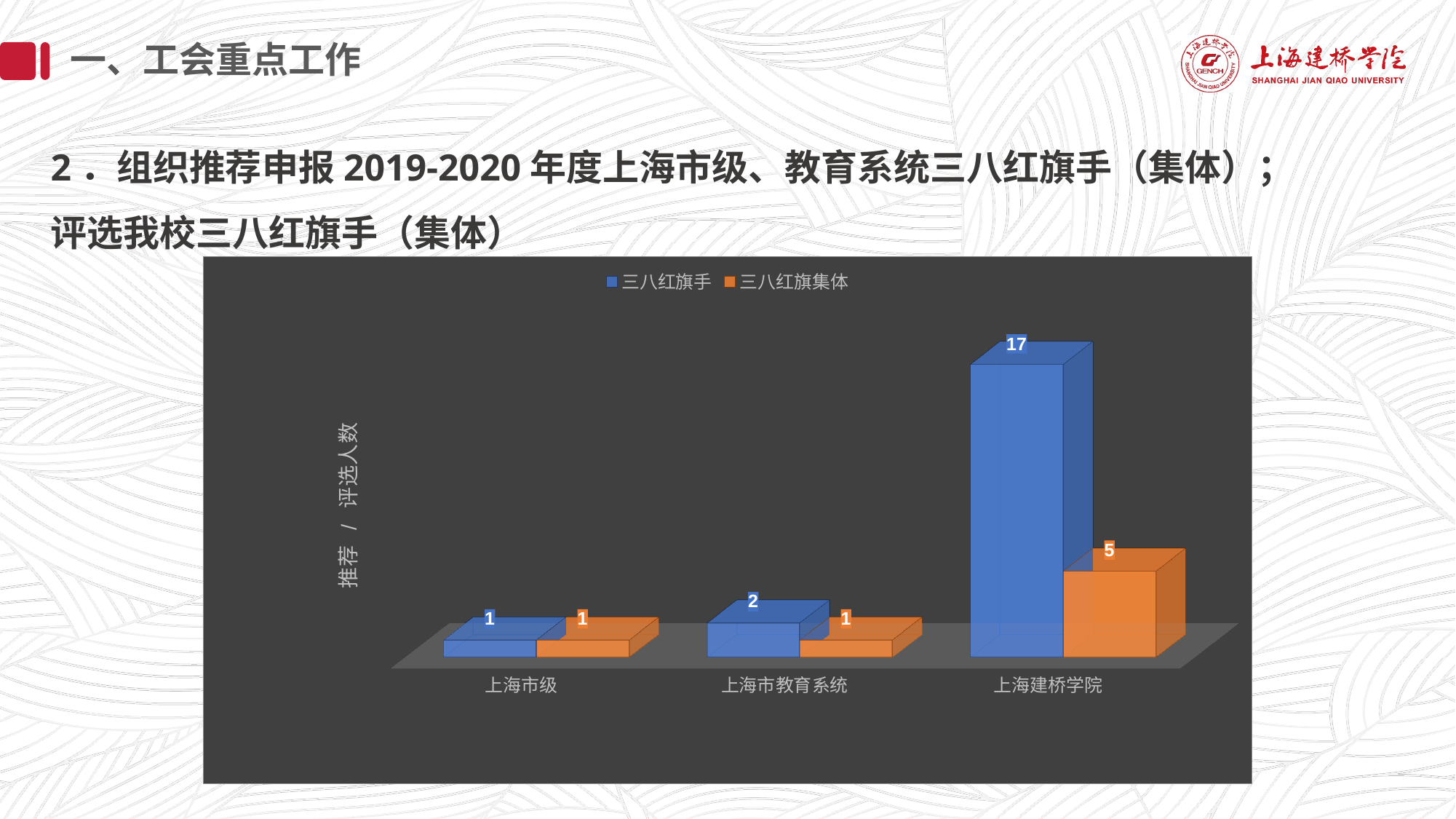
What is the difference between the 三八红旗手 and 三八红旗集体 values for 上海建桥学院? 12 What is the value for 三八红旗手 in the 上海市教育系统 category? 2 What is the value for 三八红旗集体 in the 上海建桥学院 category? 5 Which category has the highest value for 三八红旗手? 上海建桥学院 What kind of chart is shown on the slide? bar chart What is the label of the vertical axis? 推荐 / 评选人数 How many series does the legend list? 2 How many categories are shown on the x axis? 3 What is the value for 三八红旗手 in the 上海建桥学院 category? 17 Which is larger: the 三八红旗手 value for 上海市教育系统 or the 三八红旗手 value for 上海市级? 上海市教育系统 What is the value for 三八红旗集体 in the 上海市级 category? 1 Which category has the lowest value for 三八红旗手? 上海市级